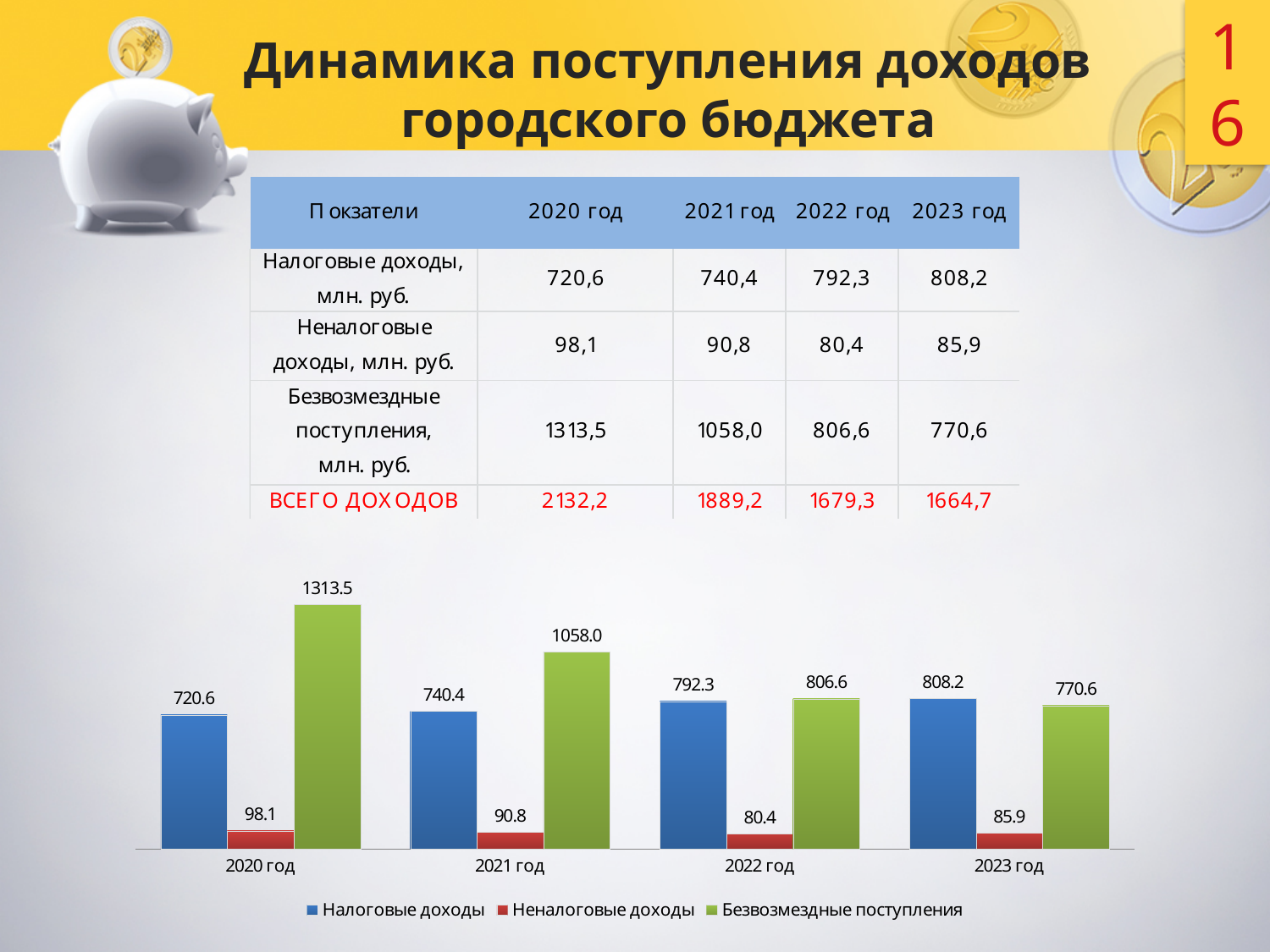
How many series does the chart legend list? 3 What is the value of Налоговые доходы for 2020 год in the chart? 720.6 What type of chart is shown on the slide? Bar chart How many year categories are shown on the x axis of the chart? 4 What is the difference between Налоговые доходы in 2023 год and 2020 год in the chart? 87.6 What is the value of Неналоговые доходы for 2023 год in the chart? 85.9 Do the values of Налоговые доходы rise or fall from 2020 год to 2023 год? Rise Which is larger in 2022 год: Налоговые доходы or Безвозмездные поступления? Безвозмездные поступления What is the value of Безвозмездные поступления for 2021 год in the chart? 1058.0 In which year is Неналоговые доходы lowest in the chart? 2022 год Which colour represents Неналоговые доходы in the chart? Red In which year is Безвозмездные поступления highest in the chart? 2020 год